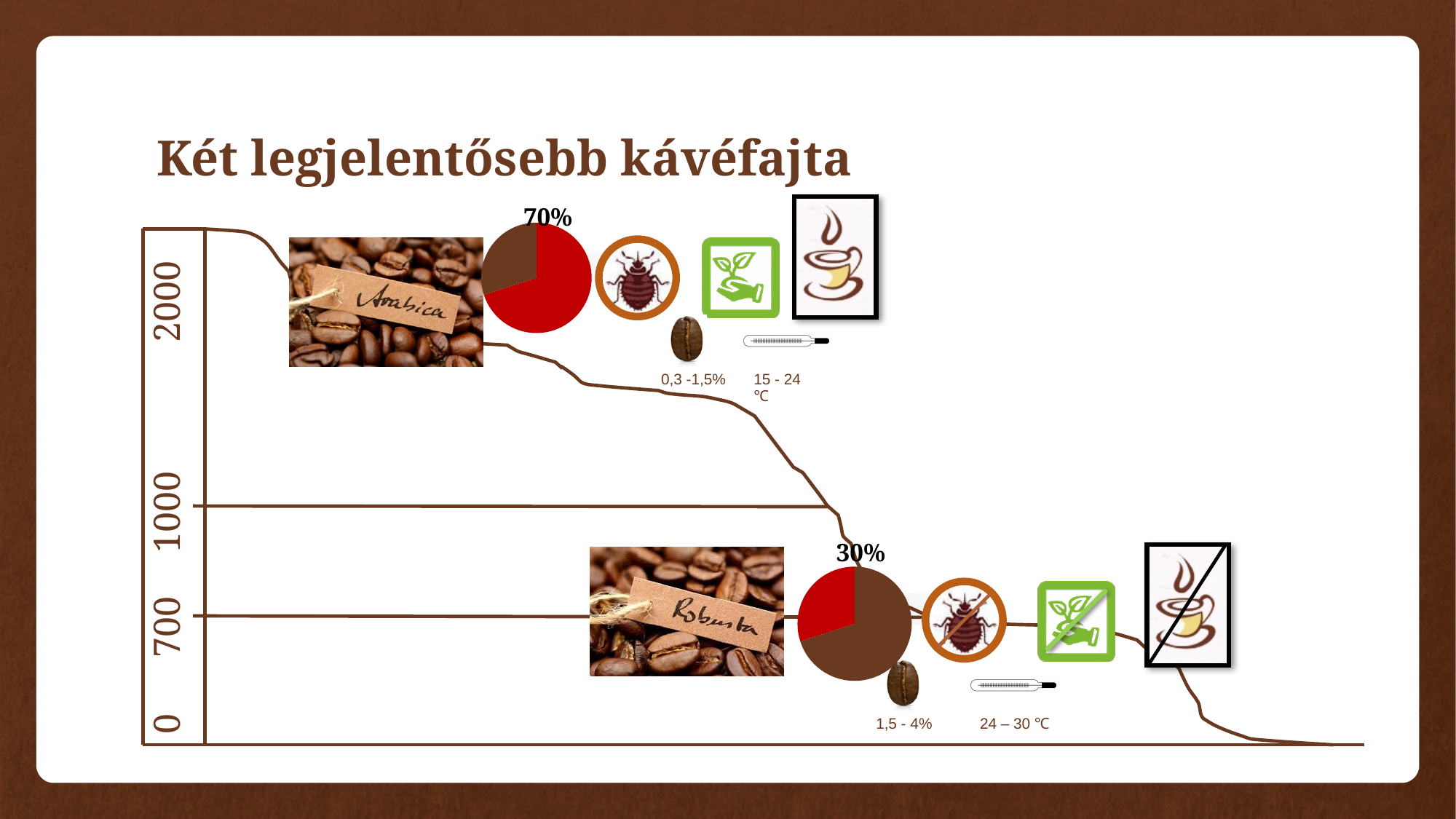
How many pie charts are on the slide? 2 In the pie chart next to the Arabica label, what colour is the larger slice? red What percentage range is printed next to the coffee bean icon below the Robusta pie chart? 1,5 - 4% What percentage is labelled on the pie chart next to the Arabica label? 70% What is the difference between the percentage labelled on the Arabica pie chart and the percentage labelled on the Robusta pie chart? 40% What temperature range is printed below the Arabica pie chart? 15 - 24 °C What kind of chart is shown next to the Arabica label? pie chart What is the lowest value labelled on the vertical axis of the elevation diagram? 0 What is the highest value labelled on the vertical axis of the elevation diagram? 2000 Which pie chart shows the larger labelled share, the one next to Arabica or the one next to Robusta? Arabica In the pie chart next to the Robusta label, what colour is the larger slice? brown What percentage is labelled on the pie chart next to the Robusta label? 30%